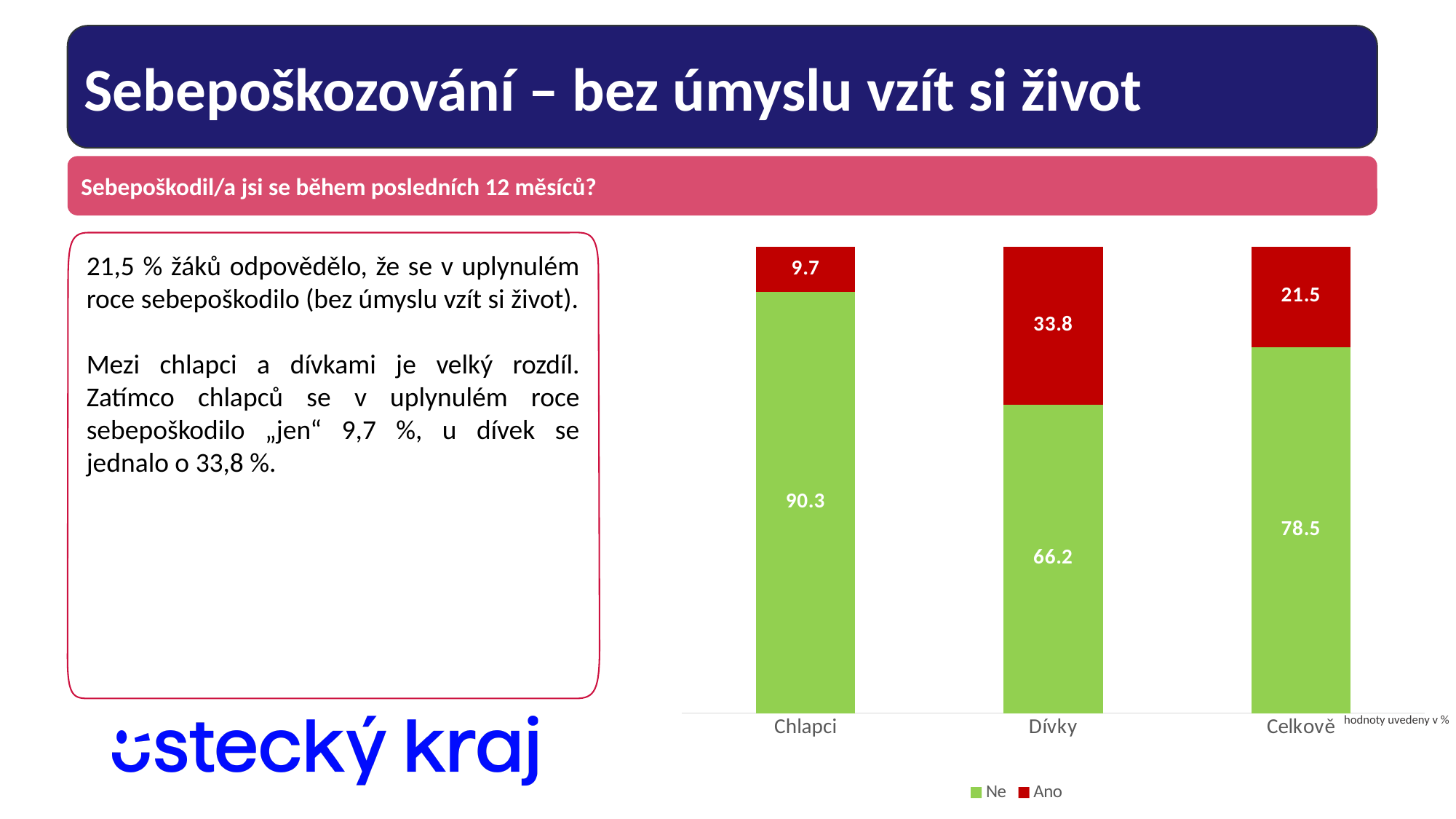
What kind of chart is shown on the slide? Stacked bar chart What is the total of the stacked bar for Dívky? 100 How many categories are shown on the x axis? 3 What is the value for "Ne" for Dívky? 66.2 What is the difference between the "Ano" values for Dívky and Chlapci? 24.1 Which category has the lowest "Ne" value? Dívky Which colour represents the "Ano" series? Red How many series does the legend list? 2 What is the value for "Ano" for Chlapci? 9.7 Which is larger: the "Ne" value for Chlapci or for Celkově? Chlapci Which category has the highest "Ano" value? Dívky What is the value for "Ano" for Celkově? 21.5